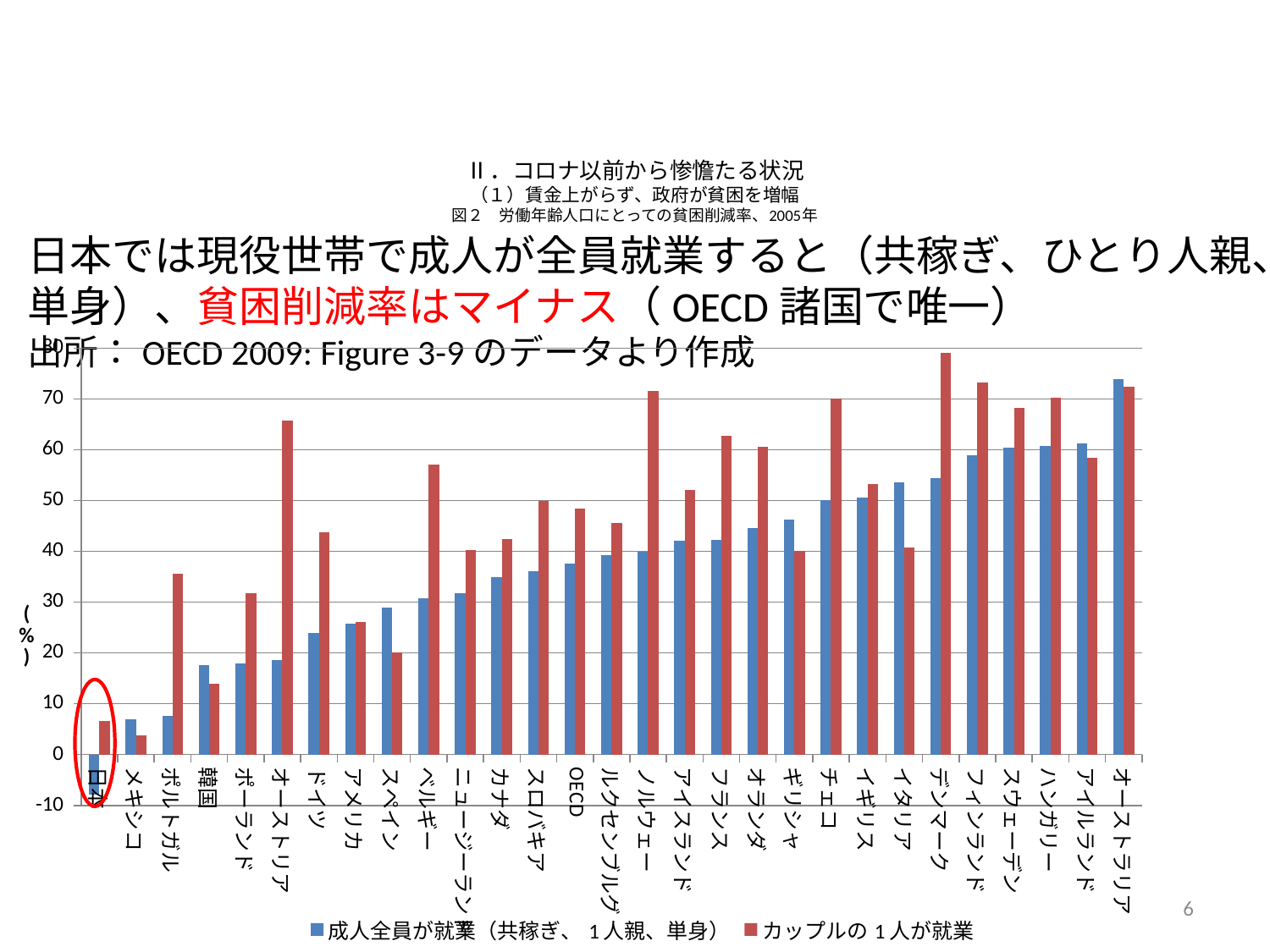
Is the カップルの1人が就業 value for ノルウェー greater or less than 70? greater Do the values of the 成人全員が就業 series generally rise or fall from left to right along the x axis? rise Which category has the highest value for the 成人全員が就業 series? オーストラリア For オーストリア, which series has the larger value, 成人全員が就業 or カップルの1人が就業? カップルの1人が就業 What kind of chart is shown on the slide? bar chart Which category has the highest value for the カップルの1人が就業 series? デンマーク How many countries/categories are shown on the x axis? 29 Is the カップルの1人が就業 value for オーストリア greater or less than 60? greater How many series does the legend list? 2 Is the 成人全員が就業 value for 日本 greater or less than 0? less Which category has the lowest value for the 成人全員が就業 series? 日本 For イタリア, which series has the larger value, 成人全員が就業 or カップルの1人が就業? 成人全員が就業